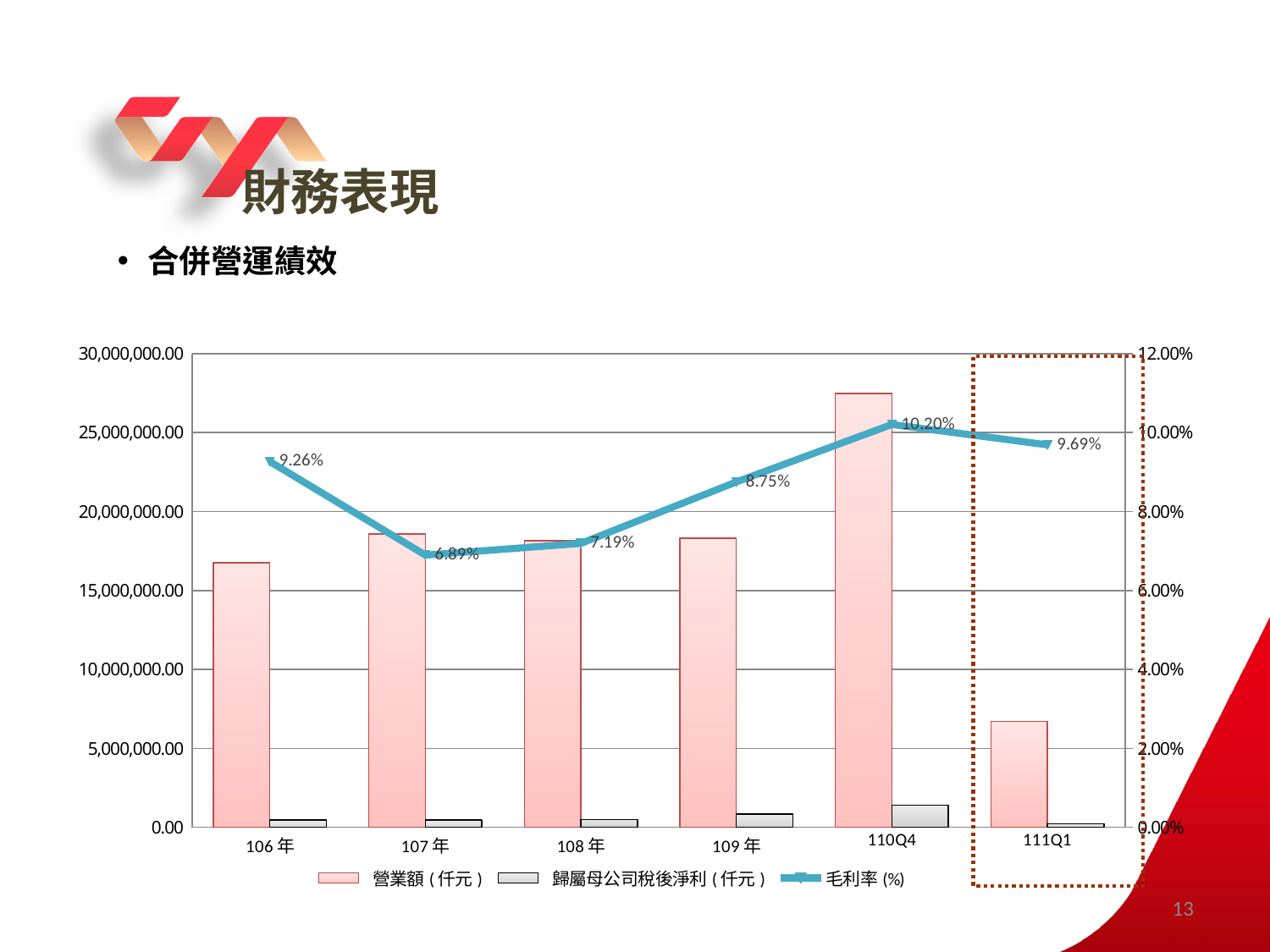
Which period has the highest 毛利率 (%)? 110Q4 How many periods are shown on the x axis of the chart? 6 Is the 營業額 (仟元) bar for 110Q4 greater or less than 25,000,000.00? greater How many series does the chart legend list? 3 Which period has the tallest 營業額 (仟元) bar? 110Q4 What is the 毛利率 (%) value for 110Q4? 10.20% What is the 毛利率 (%) value for 106 年? 9.26% What kind of chart is shown on the slide? Combination bar and line chart What is the difference between the 毛利率 (%) for 110Q4 and 111Q1? 0.51% Which period has the lowest 毛利率 (%)? 107 年 Is the 營業額 (仟元) bar for 111Q1 greater or less than 10,000,000.00? less Which has a higher 毛利率 (%), 108 年 or 109 年? 109 年